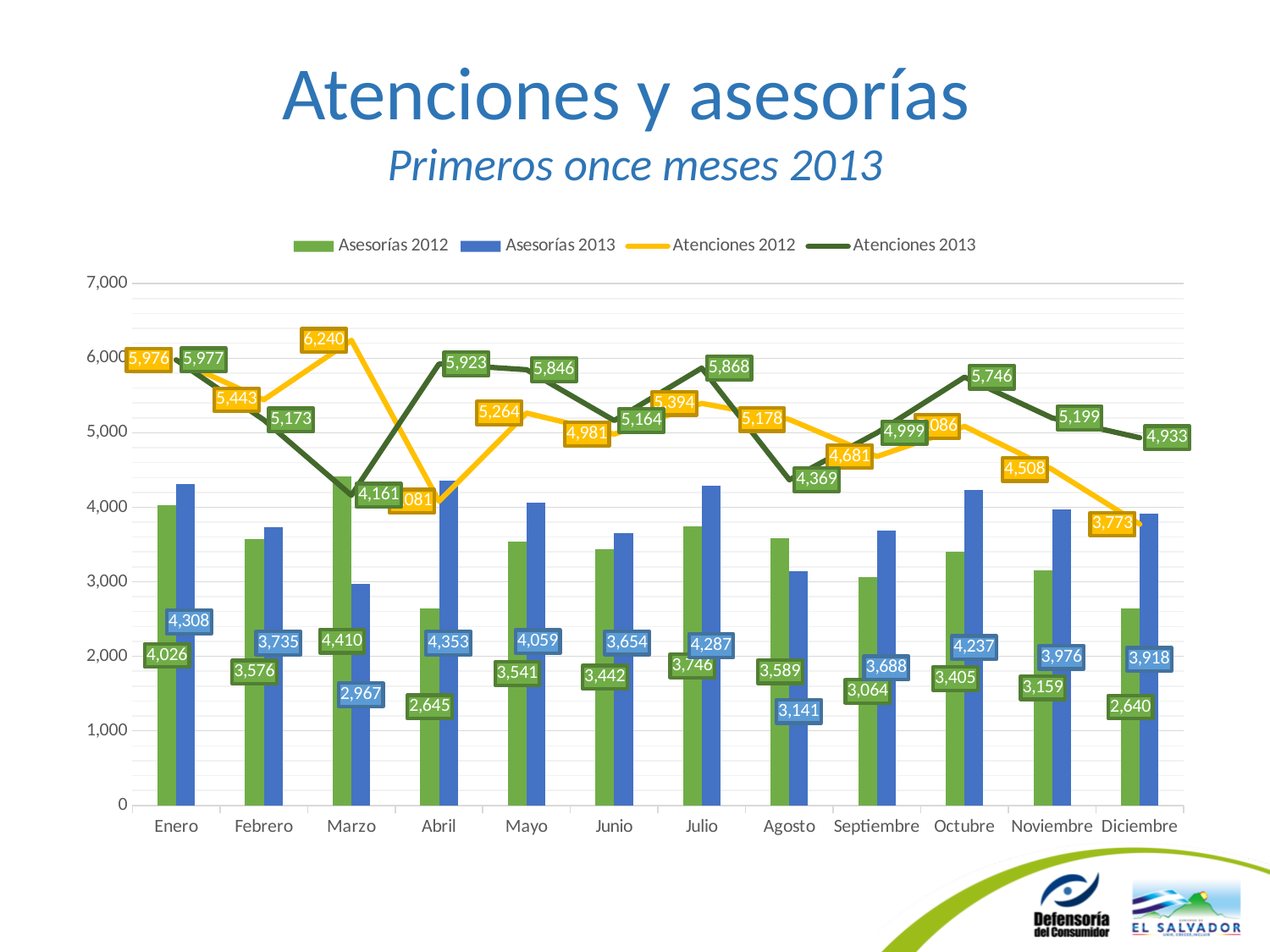
What is the difference between Asesorías 2013 and Asesorías 2012 in Diciembre? 1,278 How many series does the legend list? 4 How many months are shown on the x axis? 12 In which month is Asesorías 2013 lowest? Marzo What is the value of Asesorías 2013 in Abril? 4,353 What is the value of Asesorías 2012 in Septiembre? 3,064 What kind of chart is shown on the slide? Combined bar and line chart What is the value of Atenciones 2012 in Marzo? 6,240 In which month is Asesorías 2012 highest? Marzo In which month is Atenciones 2012 highest? Marzo In which month is Atenciones 2013 lowest? Marzo In Julio, which is larger: Atenciones 2012 or Atenciones 2013? Atenciones 2013